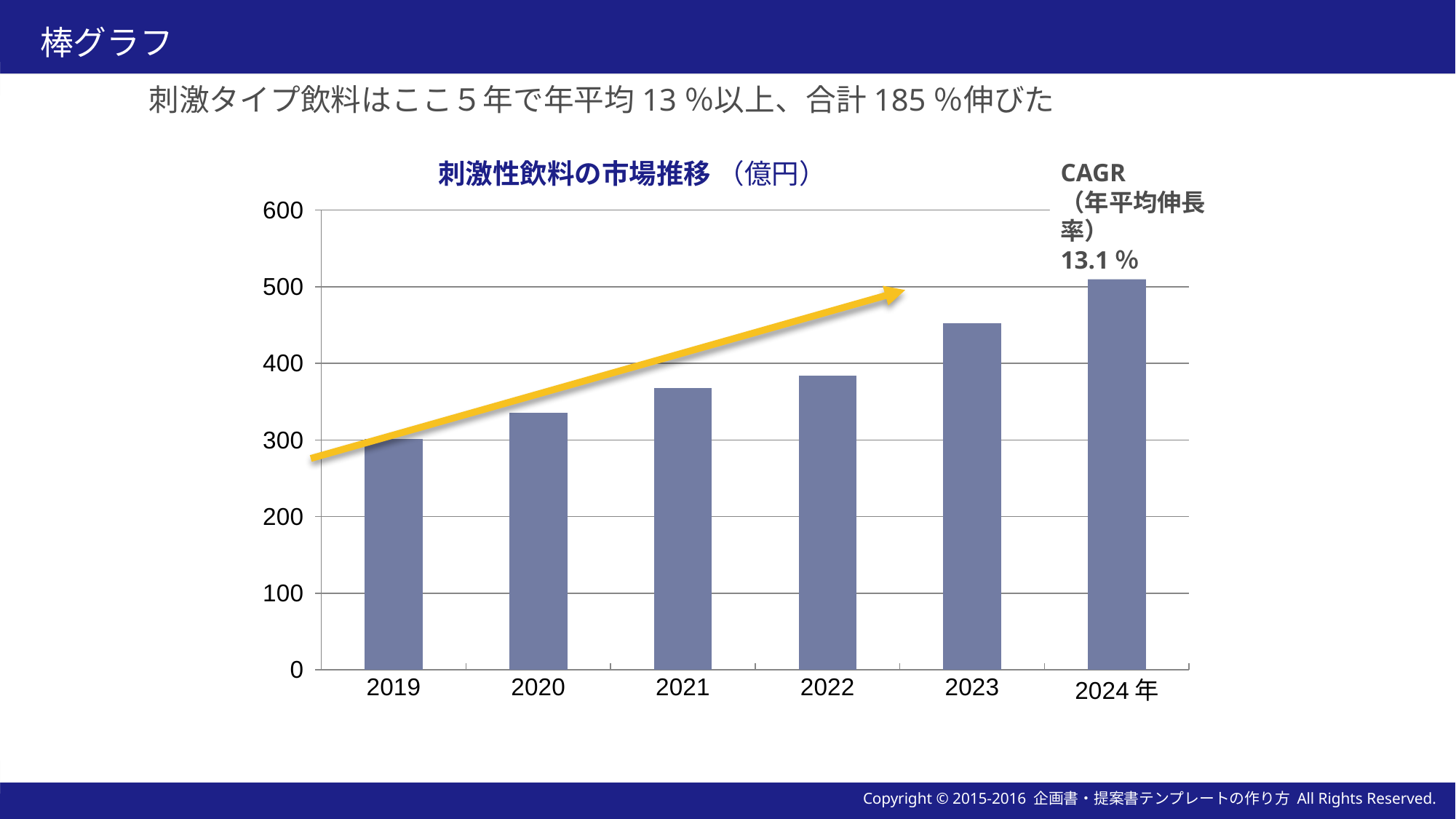
How many years are plotted on the x axis of the chart? 6 Do the bar values rise or fall from 2019 to 2024? rise What kind of chart is shown on the slide? bar chart What is the title of the chart? 刺激性飲料の市場推移（億円） Which year has the lowest bar in the chart? 2019 Is the value for 2021 greater or less than 400? less Is the value for 2020 greater or less than 300? greater Is the value for 2019 greater or less than 200? greater Which is larger, the value for 2023 or the value for 2021? 2023 What CAGR value is annotated next to the chart? 13.1 % Which year has the highest bar in the chart? 2024